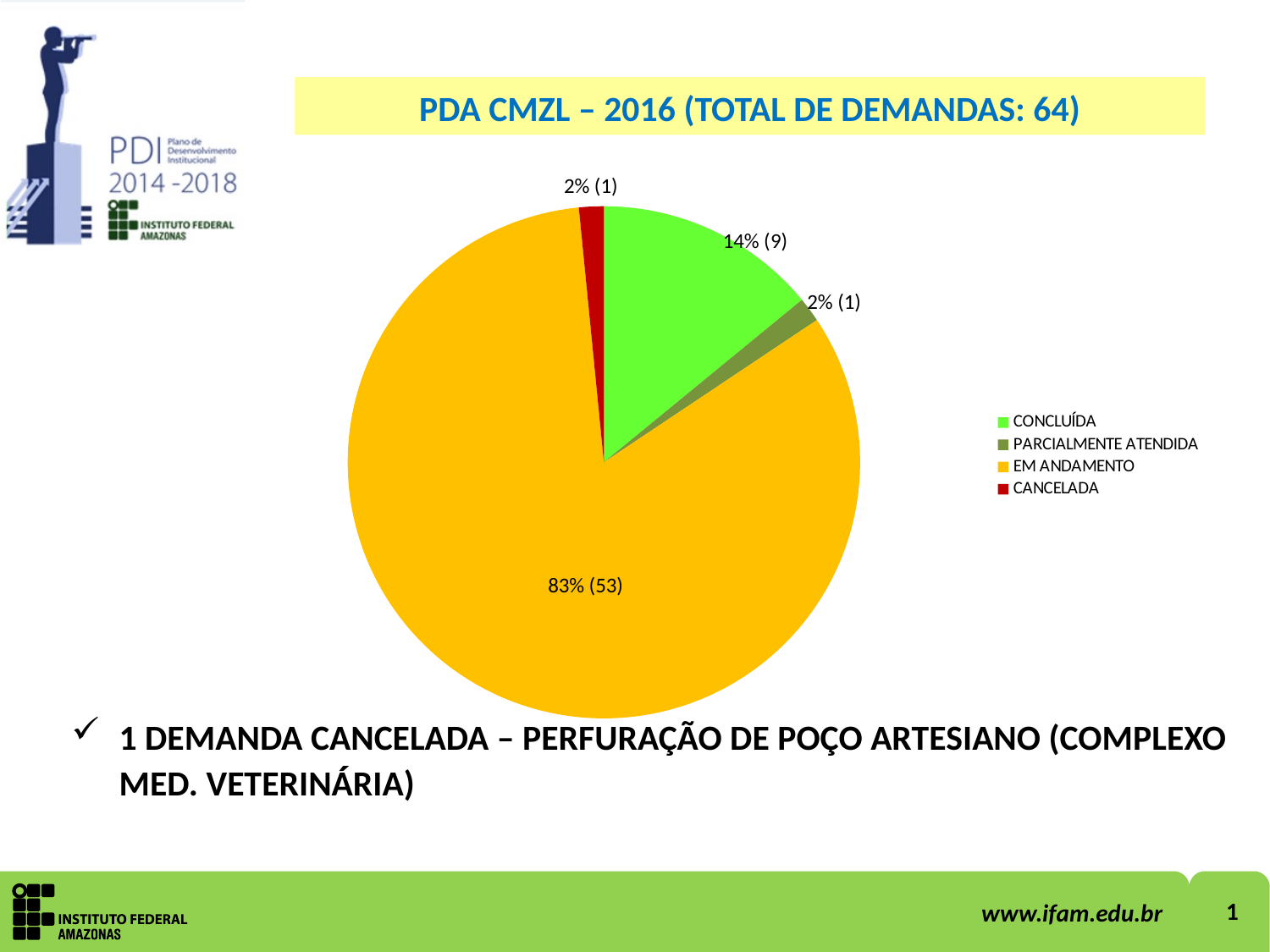
How many demands are labelled as EM ANDAMENTO? 53 What type of chart is shown on the slide? pie chart Which is larger, the CONCLUÍDA slice or the PARCIALMENTE ATENDIDA slice? CONCLUÍDA How many slices does the pie chart have? 4 How many demands are labelled as CONCLUÍDA? 9 What is the title of the chart? PDA CMZL – 2016 (TOTAL DE DEMANDAS: 64) How many demands are labelled as CANCELADA? 1 How many entries does the legend list? 4 What is the difference in number of demands between EM ANDAMENTO and CONCLUÍDA? 44 What share of the pie does EM ANDAMENTO represent? 83% Which category has the largest slice of the pie? EM ANDAMENTO What share of the pie does CONCLUÍDA represent? 14%